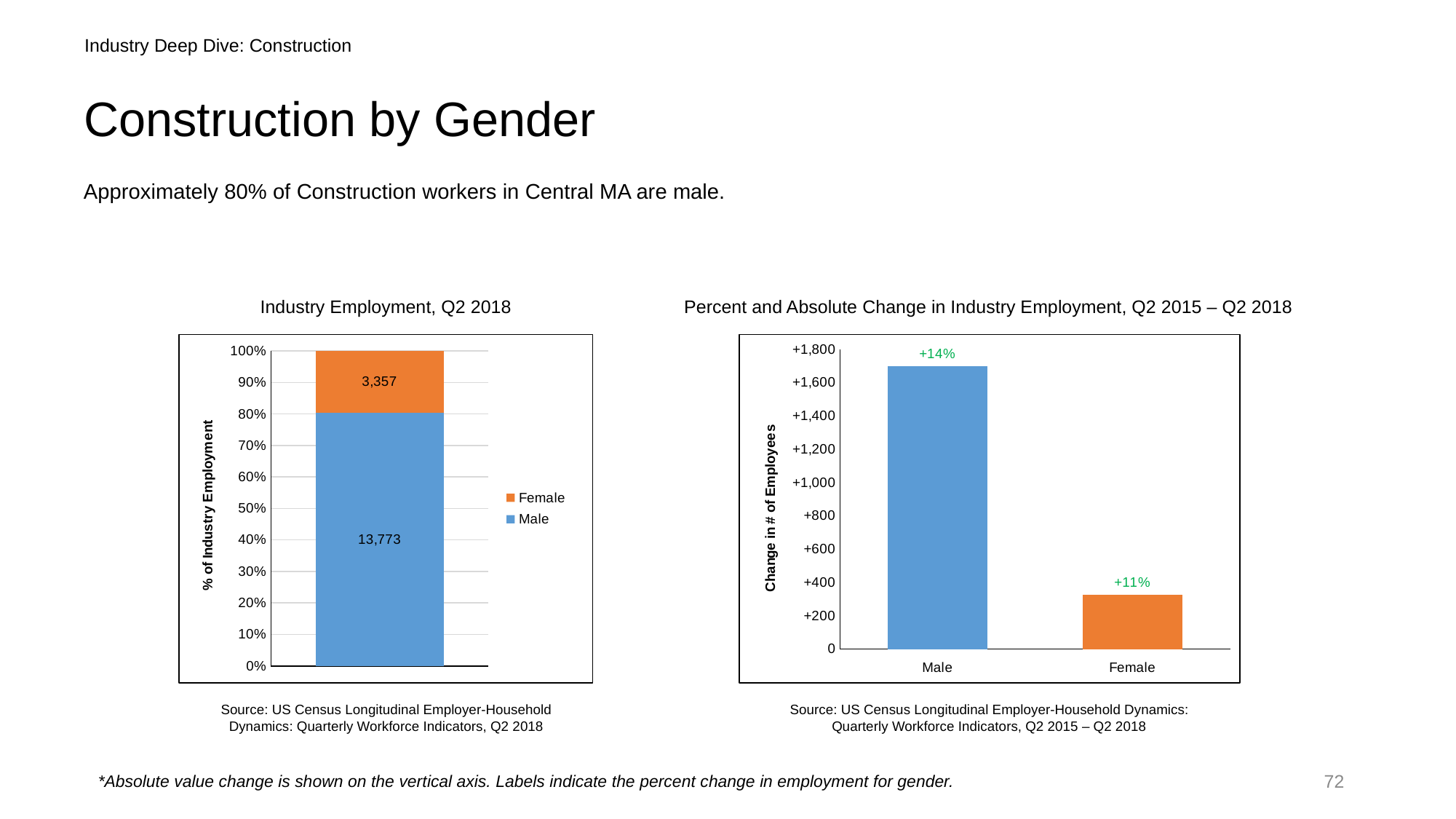
In the 'Industry Employment, Q2 2018' chart, what is the data label on the Male segment? 13,773 In the 'Percent and Absolute Change in Industry Employment, Q2 2015 – Q2 2018' chart, which category has the higher bar? Male In the 'Percent and Absolute Change in Industry Employment, Q2 2015 – Q2 2018' chart, what percent change label is shown for Male? +14% In the 'Percent and Absolute Change in Industry Employment, Q2 2015 – Q2 2018' chart, is the value for Female greater or less than +400? less In the 'Percent and Absolute Change in Industry Employment, Q2 2015 – Q2 2018' chart, what percent change label is shown for Female? +11% In the 'Industry Employment, Q2 2018' chart, how many series does the legend list? 2 What kind of chart is the 'Percent and Absolute Change in Industry Employment, Q2 2015 – Q2 2018' chart? Bar chart In the 'Industry Employment, Q2 2018' chart, what is the total of the Male and Female values in the stacked bar? 17,130 In the 'Percent and Absolute Change in Industry Employment, Q2 2015 – Q2 2018' chart, is the value for Male greater or less than +1,600? greater In the 'Industry Employment, Q2 2018' chart, which colour represents Female? Orange In the 'Industry Employment, Q2 2018' chart, what is the difference between the Male and Female values? 10,416 In the 'Industry Employment, Q2 2018' chart, what is the data label on the Female segment? 3,357